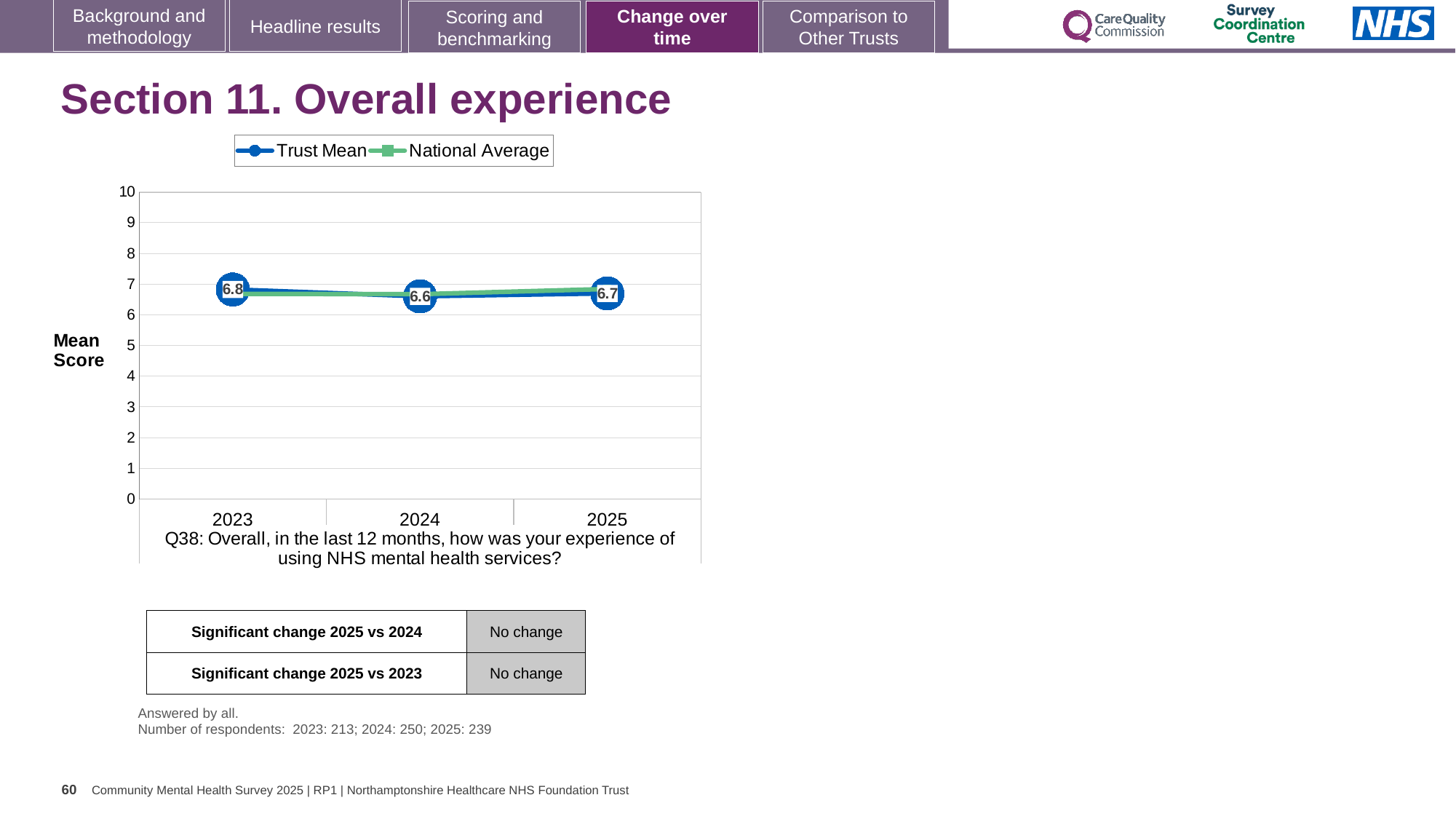
How many years are plotted on the x axis? 3 What is the difference between the Trust Mean in 2023 and in 2024? 0.2 How many series does the legend list? 2 What is the Trust Mean score for 2023? 6.8 What kind of chart is shown on the slide? line chart In which year is the Trust Mean highest? 2023 What is the Trust Mean score for 2024? 6.6 Is the National Average value for 2024 greater or less than 5? greater Which year has the larger Trust Mean, 2023 or 2025? 2023 What is the Trust Mean score for 2025? 6.7 Does the Trust Mean rise or fall from 2023 to 2024? fall In which year is the Trust Mean lowest? 2024